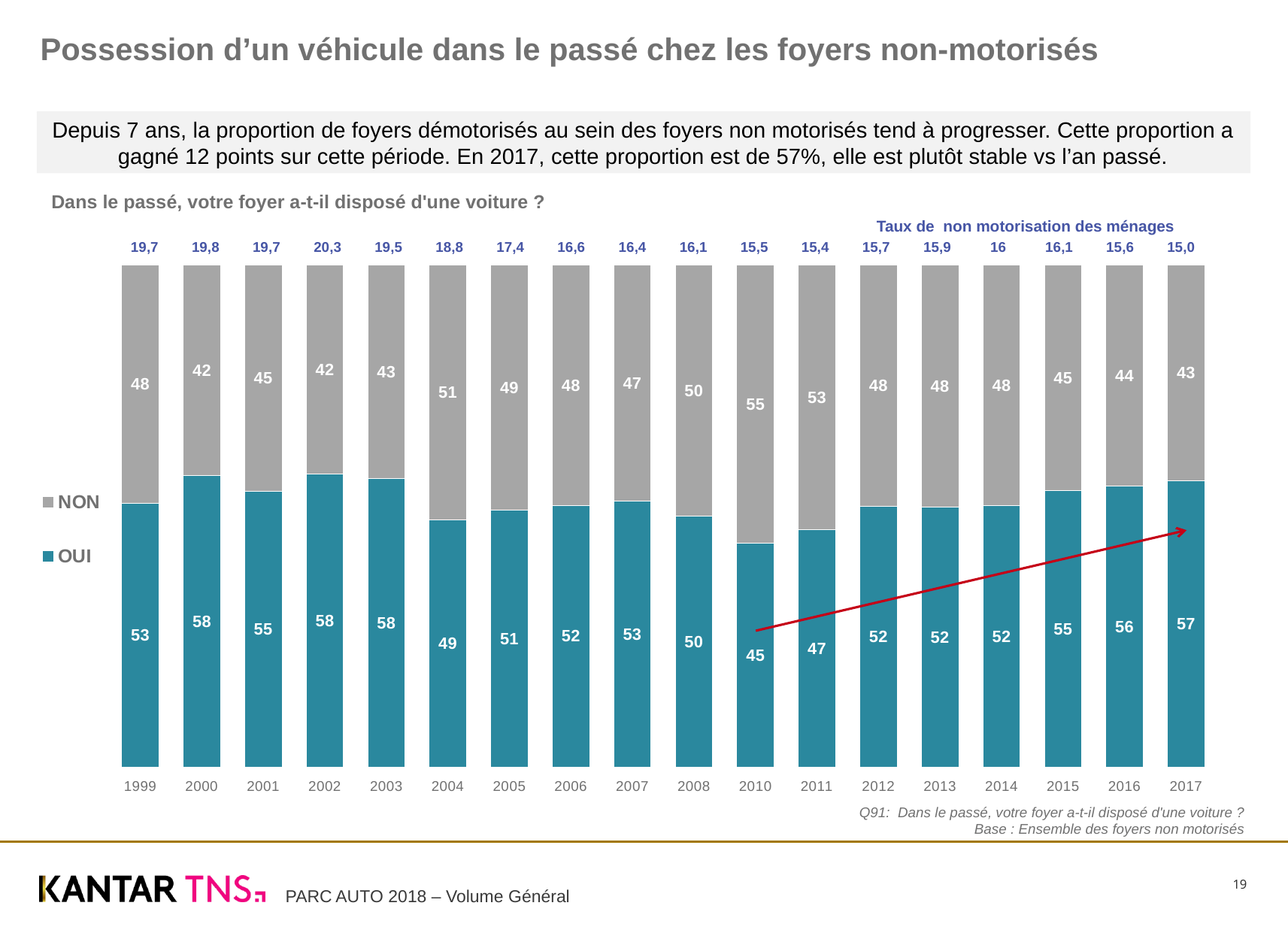
In which year is the 'Taux de non motorisation des ménages' the lowest? 2017 What is the 'Taux de non motorisation des ménages' value shown above the bar for 2002? 20,3 What is the difference between the OUI value in 2017 and the OUI value in 2010? 12 Which is larger, the OUI value for 2000 or the OUI value for 2004? 2000 In which year is the OUI value the lowest? 2010 What is the total of the stacked bar for 2017 (OUI plus NON)? 100 How many series does the legend list? 2 How many years are shown on the x axis? 18 In which year is the NON value the highest? 2010 What kind of chart is shown on the slide? stacked bar chart What is the OUI value for 2017? 57 What is the NON value for 2010? 55